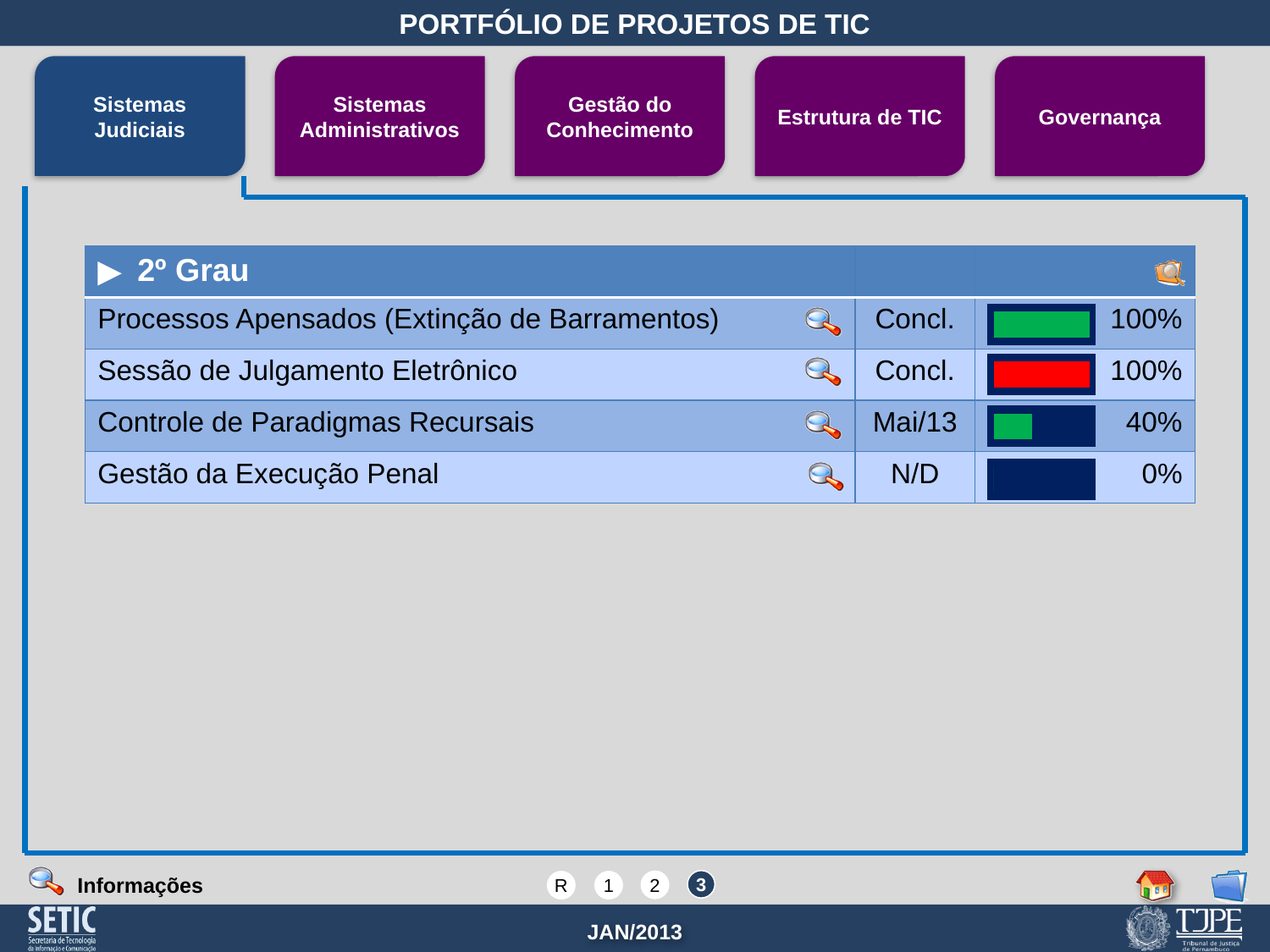
In the 2º Grau table, how many projects are marked as Concl.? 2 In the 2º Grau table, what completion percentage is shown for Controle de Paradigmas Recursais? 40% In the 2º Grau table, what is the deadline shown for Controle de Paradigmas Recursais? Mai/13 In the 2º Grau table, what completion percentage is shown for Gestão da Execução Penal? 0% In the 2º Grau table, what is the difference in completion percentage between Sessão de Julgamento Eletrônico and Controle de Paradigmas Recursais? 60% In the 2º Grau table, what completion percentage is shown for Sessão de Julgamento Eletrônico? 100% In the 2º Grau table, what status is shown for Gestão da Execução Penal? N/D How many projects are listed in the 2º Grau table? 4 In the 2º Grau table, which project has the lowest completion percentage? Gestão da Execução Penal In the 2º Grau table, what colour is the progress bar for Sessão de Julgamento Eletrônico? Red In the 2º Grau table, which has a higher completion percentage: Controle de Paradigmas Recursais or Gestão da Execução Penal? Controle de Paradigmas Recursais In the 2º Grau table, what completion percentage is shown for Processos Apensados (Extinção de Barramentos)? 100%